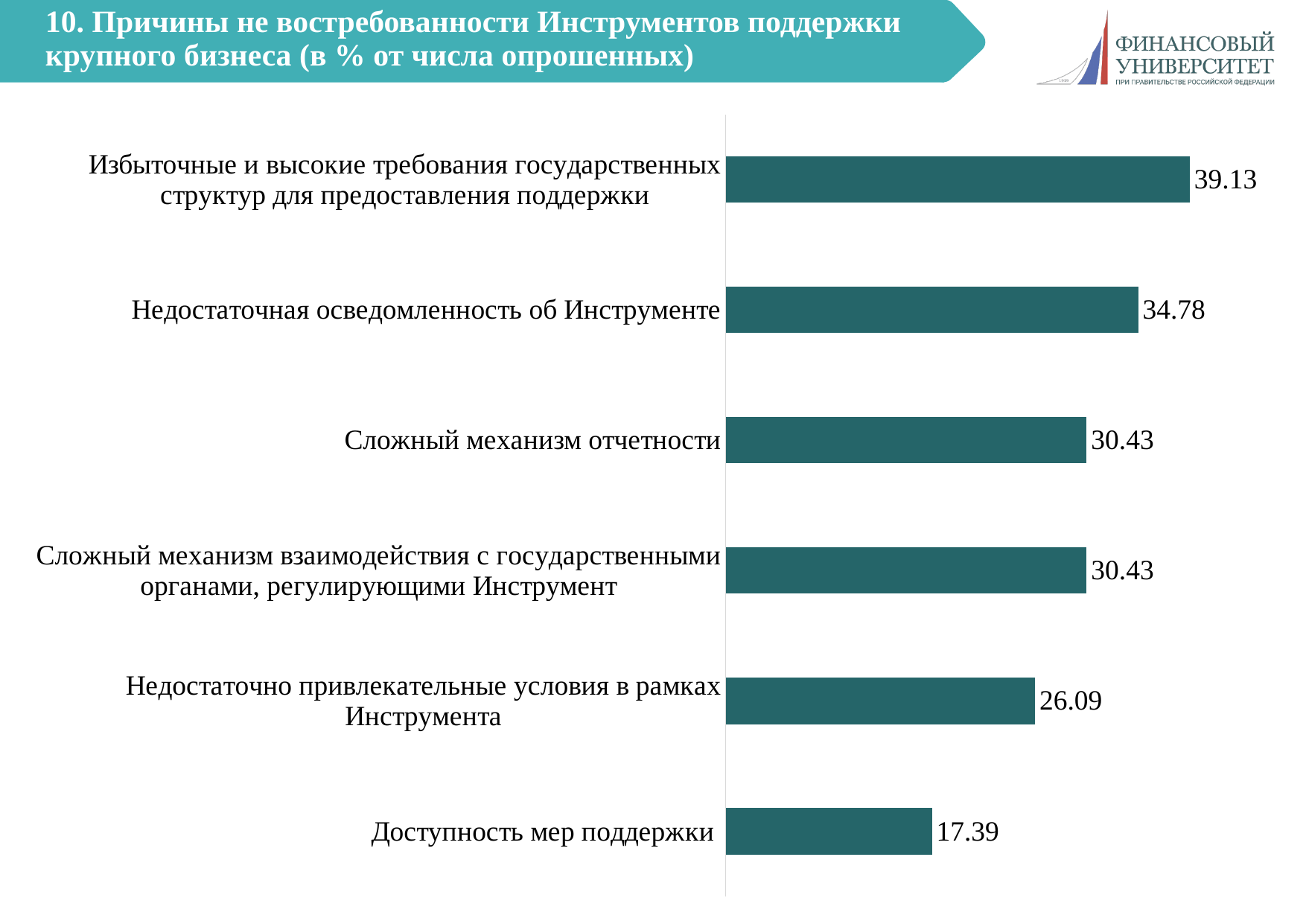
What is the difference between the values for «Избыточные и высокие требования государственных структур для предоставления поддержки» and «Доступность мер поддержки»? 21.74 What is the value for «Избыточные и высокие требования государственных структур для предоставления поддержки»? 39.13 What is the value for «Недостаточная осведомленность об Инструменте»? 34.78 Which two categories share the same value of 30.43? Сложный механизм отчетности; Сложный механизм взаимодействия с государственными органами, регулирующими Инструмент What is the value for «Недостаточно привлекательные условия в рамках Инструмента»? 26.09 Which is larger: the value for «Недостаточная осведомленность об Инструменте» or for «Недостаточно привлекательные условия в рамках Инструмента»? Недостаточная осведомленность об Инструменте What is the difference between the values for «Недостаточная осведомленность об Инструменте» and «Сложный механизм отчетности»? 4.35 Which category has the highest value? Избыточные и высокие требования государственных структур для предоставления поддержки How many categories are shown in the chart? 6 What is the value for «Доступность мер поддержки»? 17.39 Which category has the lowest value? Доступность мер поддержки What kind of chart is shown on the slide? Bar chart